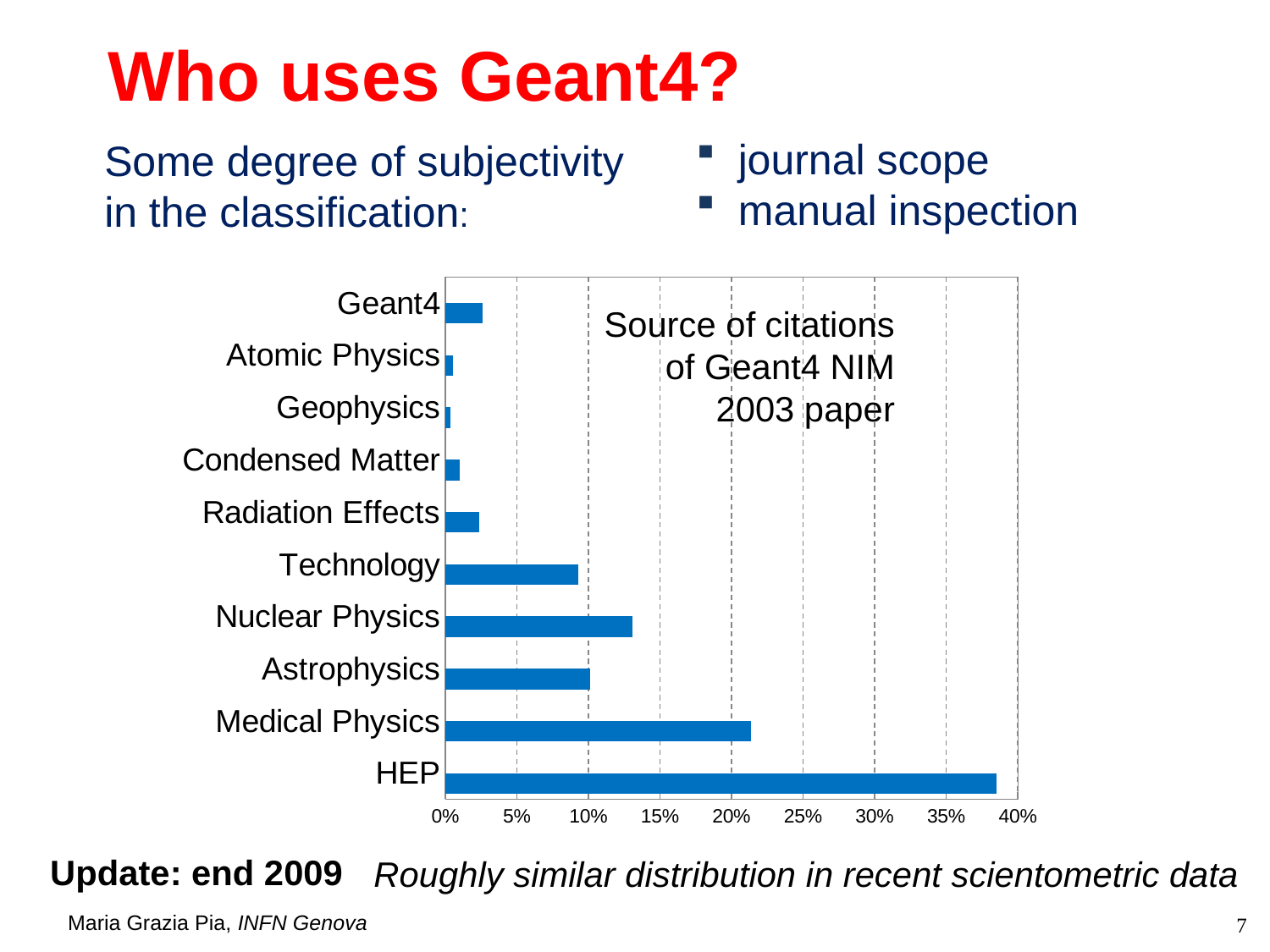
What is the maximum value shown on the horizontal axis of the chart? 40% What kind of chart is shown on the slide? bar chart How many categories are plotted in the chart? 10 Is the value for Technology greater or less than 10%? less Which category has the highest value in the chart? HEP Is the value for Radiation Effects greater or less than 5%? less Is the value for Nuclear Physics greater or less than 10%? greater Which is larger, the value for Nuclear Physics or the value for Technology? Nuclear Physics Which is larger, the value for Medical Physics or the value for Astrophysics? Medical Physics What is the title printed inside the chart? Source of citations of Geant4 NIM 2003 paper